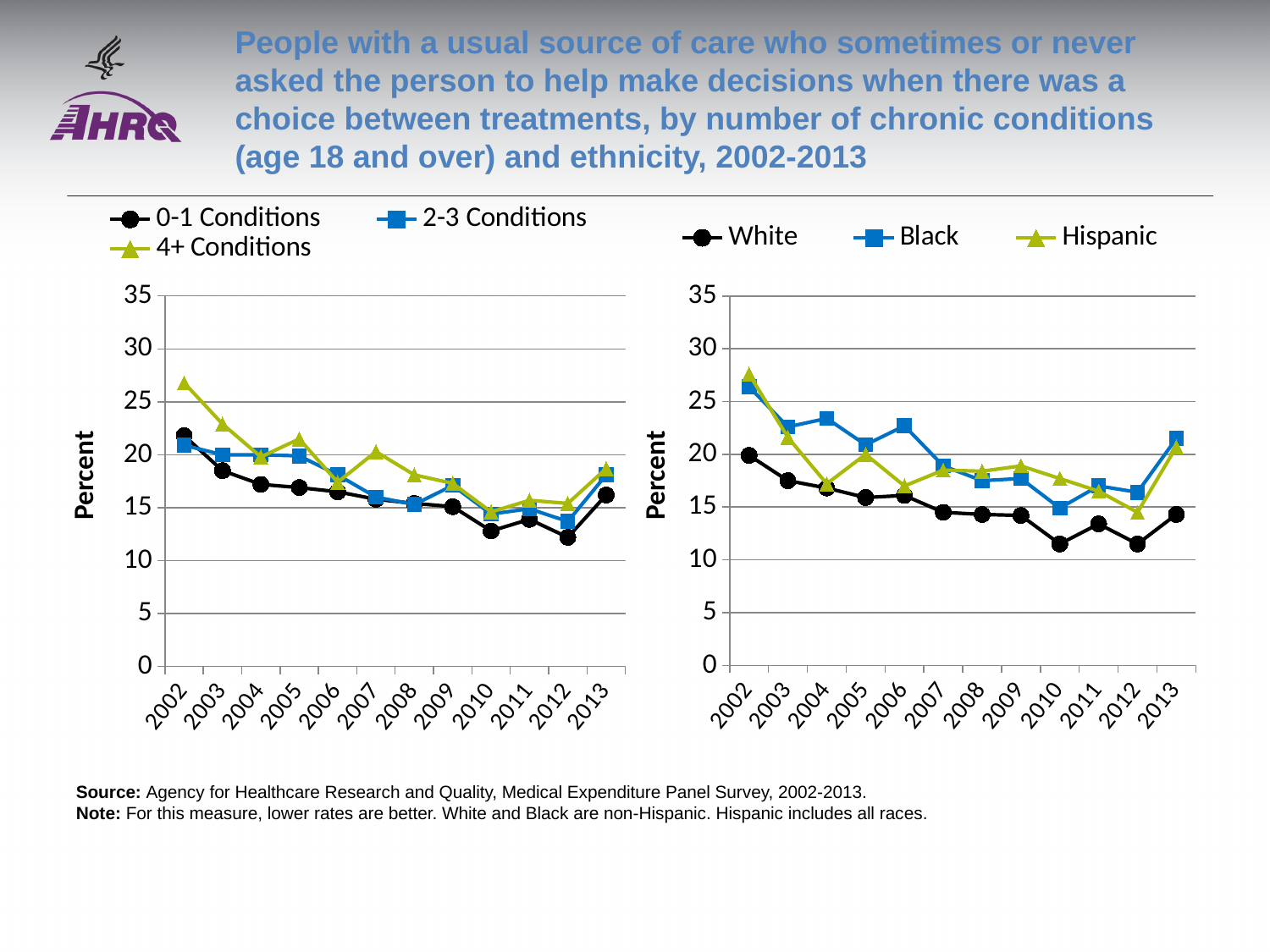
In the right chart, is the value for Black in 2013 greater or less than 20? greater In the left chart, does the 0-1 Conditions series generally rise or fall from 2002 to 2012? fall What kind of chart is the left chart (by number of chronic conditions)? line chart In the right chart, which group has the lowest value in 2010? White In the left chart, which series has the higher value in 2002: 4+ Conditions or 0-1 Conditions? 4+ Conditions How many series does the legend of the left chart list? 3 In the left chart, is the value for 0-1 Conditions in 2012 greater or less than 15? less How many series does the legend of the right chart (by ethnicity) list? 3 In the right chart, is the value for White in 2010 greater or less than 15? less In the right chart, which group has the highest value in 2004? Black How many years are shown on the x axis of the right chart? 12